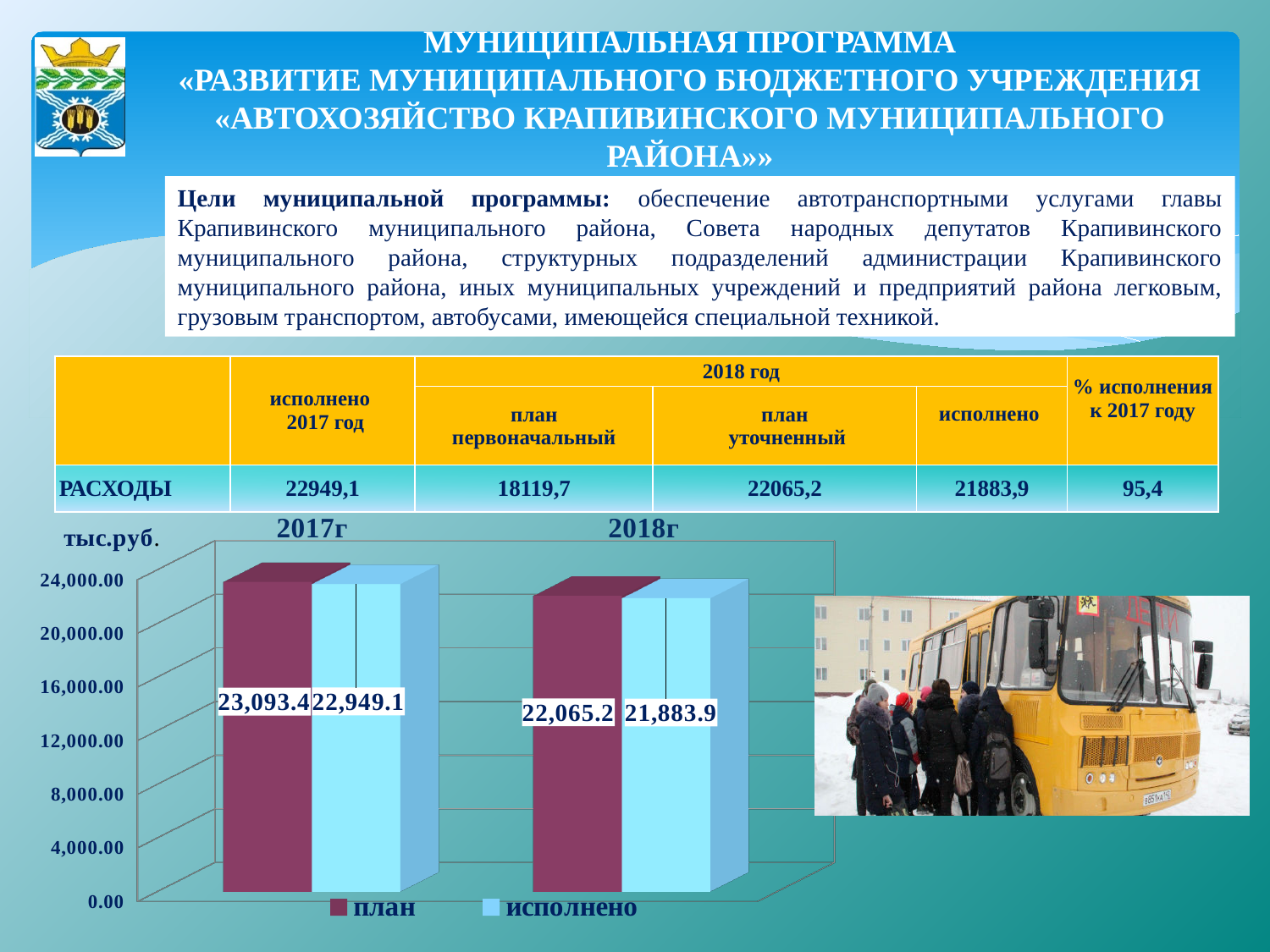
What is the value of план for 2018г in the chart? 22,065.2 What is the value of план for 2017г in the chart? 23,093.4 What is the value of исполнено for 2018г in the chart? 21,883.9 What unit label is shown above the vertical axis of the chart? тыс.руб. How many series does the chart legend list? 2 Which year has the higher план value in the chart? 2017г What kind of chart is shown on the slide? bar chart How many year categories are shown on the x axis of the chart? 2 What is the difference between план and исполнено for 2018г in the chart? 181.3 Does the исполнено value rise or fall from 2017г to 2018г in the chart? fall What is the value of исполнено for 2017г in the chart? 22,949.1 Which year has the lower исполнено value in the chart? 2018г